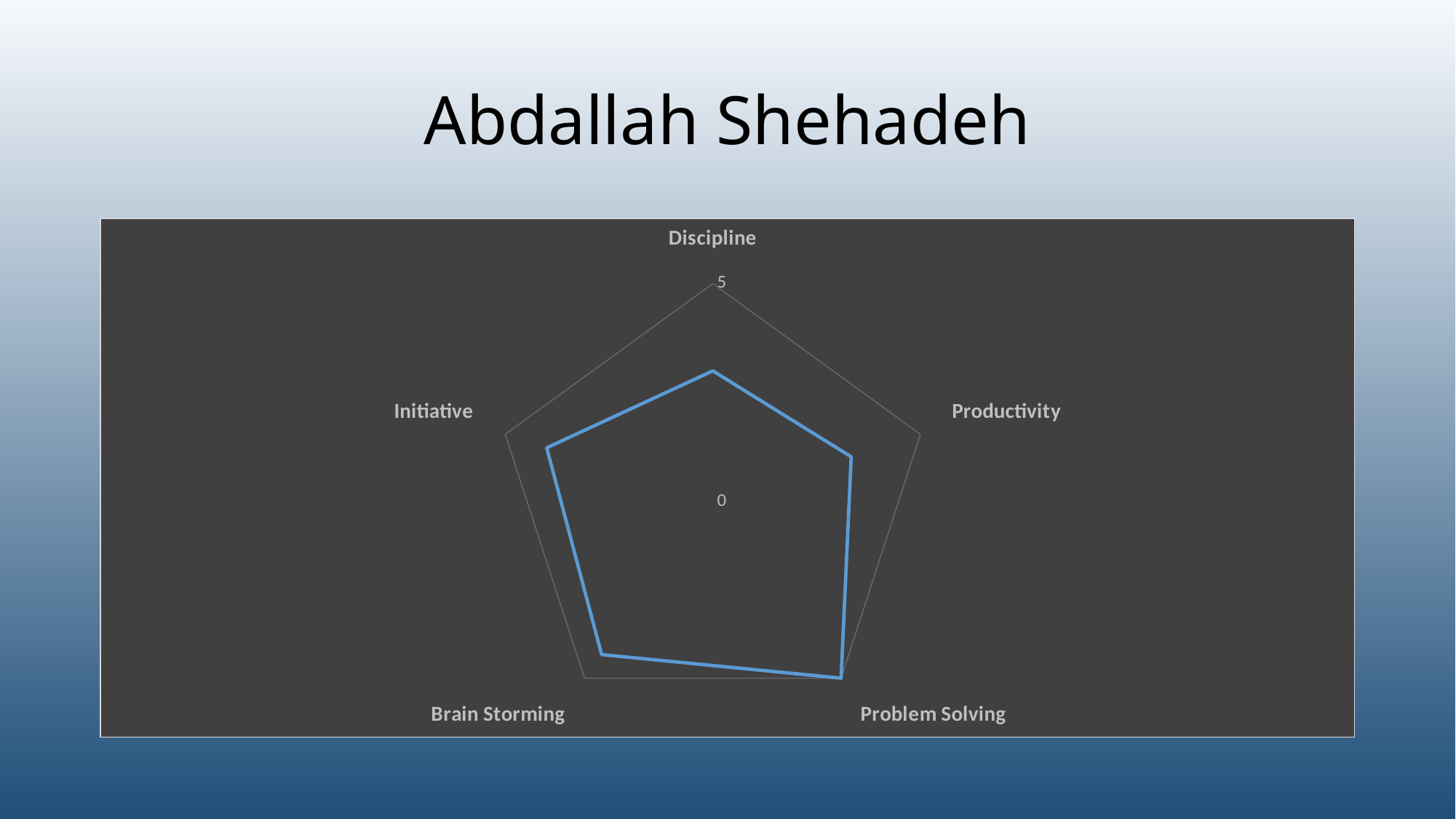
What kind of chart is shown on the slide? radar chart Which is larger, the value for Brain Storming or the value for Discipline? Brain Storming What colour is the data line on the radar chart? blue How many categories (axes) does the radar chart have? 5 Is the value for Discipline greater or less than 5? less What is the maximum value shown on the radar chart's axis? 5 Which category has the highest value on the radar chart? Problem Solving Is the value for Initiative greater or less than 0? greater Is the value for Productivity greater or less than 5? less What is the value for Problem Solving on the radar chart? 5 Which is larger, the value for Problem Solving or the value for Discipline? Problem Solving